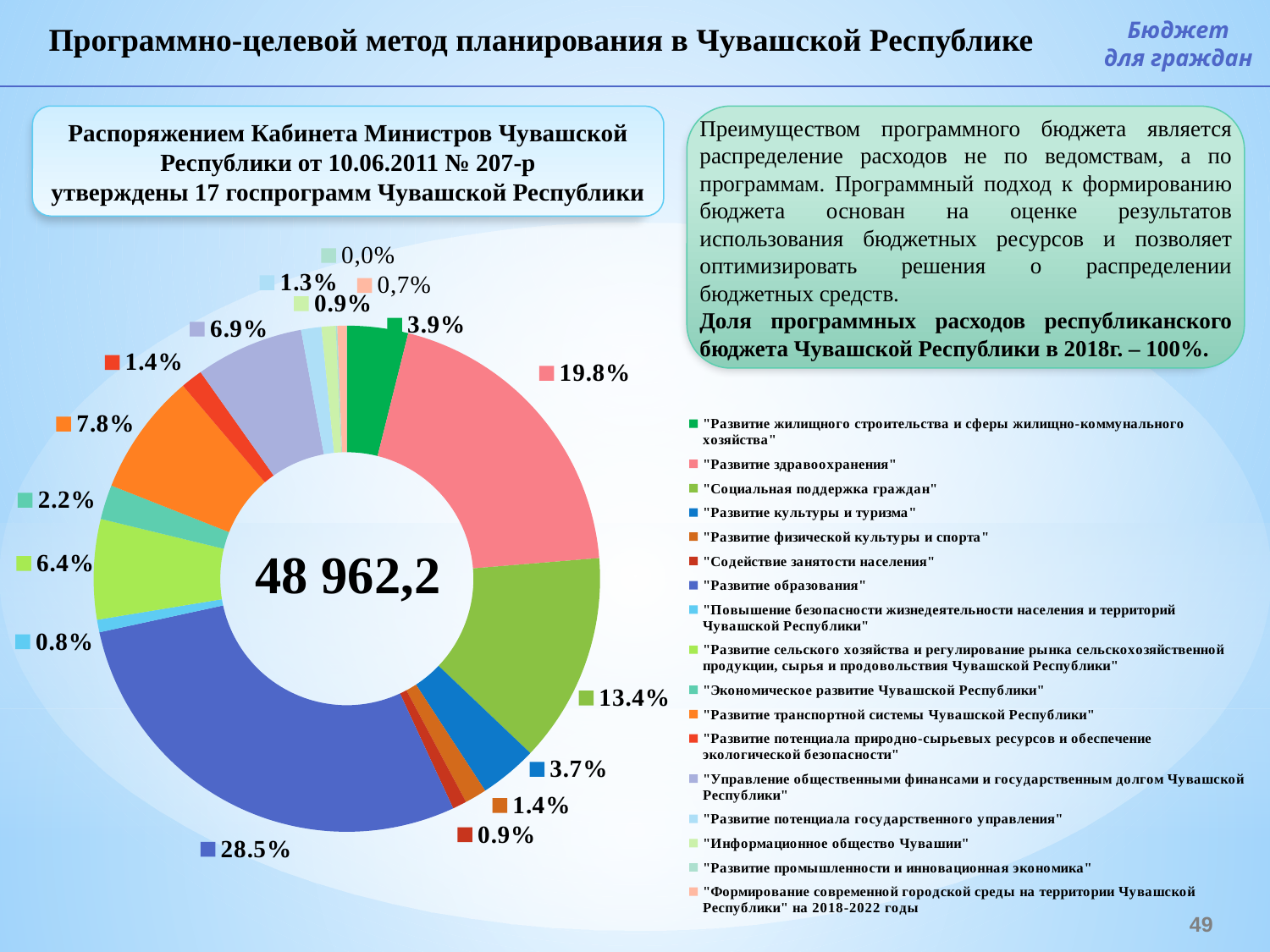
Какое значение указано в центре кольцевой диаграммы? 48 962,2 Что больше: доля «Развития здравоохранения» или доля «Социальной поддержки граждан»? «Развитие здравоохранения» Какая доля приходится на госпрограмму «Социальная поддержка граждан»? 13.4% На сколько процентных пунктов доля «Развития образования» больше доли «Развития здравоохранения»? 8.7 Сколько госпрограмм перечислено в легенде диаграммы? 17 Какая доля приходится на госпрограмму «Развитие образования»? 28.5% Какой тип диаграммы показан на слайде? кольцевая (круговая) диаграмма Какая доля приходится на госпрограмму «Развитие транспортной системы Чувашской Республики»? 7.8% Какова сумма долей «Развития образования» и «Развития здравоохранения»? 48.3% Какая госпрограмма имеет наибольшую долю на диаграмме? «Развитие образования» Какая госпрограмма имеет наименьшую долю на диаграмме? «Развитие промышленности и инновационная экономика» (0,0%) Какая доля приходится на госпрограмму «Развитие здравоохранения»? 19.8%